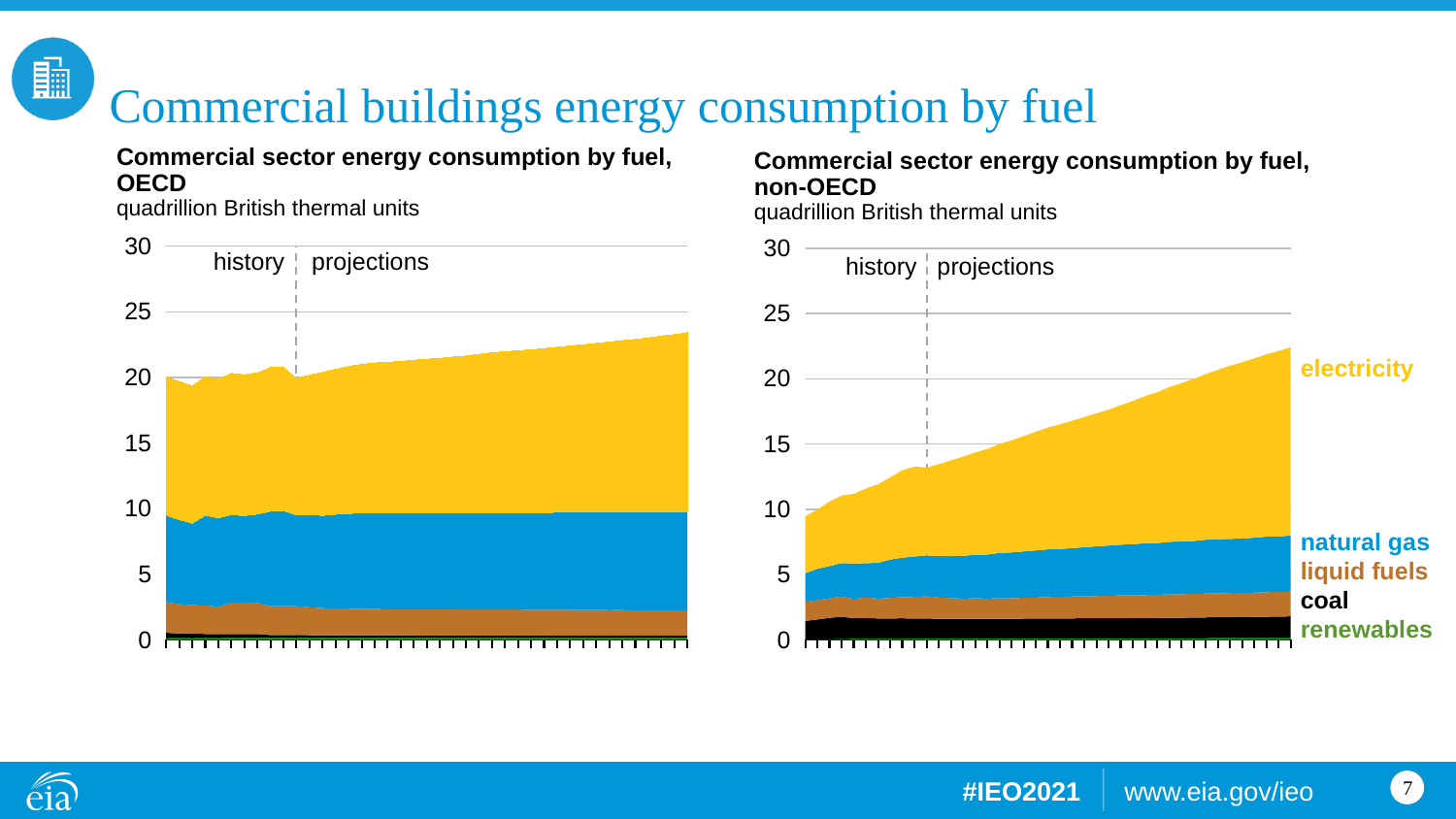
In the non-OECD chart, is total consumption at the end of the projection period greater or less than 20 quadrillion Btu? greater In the OECD chart, is total consumption at the end of the projection period greater or less than 20 quadrillion Btu? greater In the non-OECD chart, is total consumption at the start of the history period greater or less than 15 quadrillion Btu? less What unit of measurement is used on both charts? quadrillion British thermal units How many fuel series does the legend on the non-OECD chart list? 5 In the non-OECD chart, which fuel accounts for the largest share of consumption at the end of the projection period? electricity What kind of chart is the 'Commercial sector energy consumption by fuel, OECD' chart? stacked area chart What does the vertical dashed line in each chart separate? history and projections In the non-OECD chart, does total commercial energy consumption rise or fall over the projection period? rise